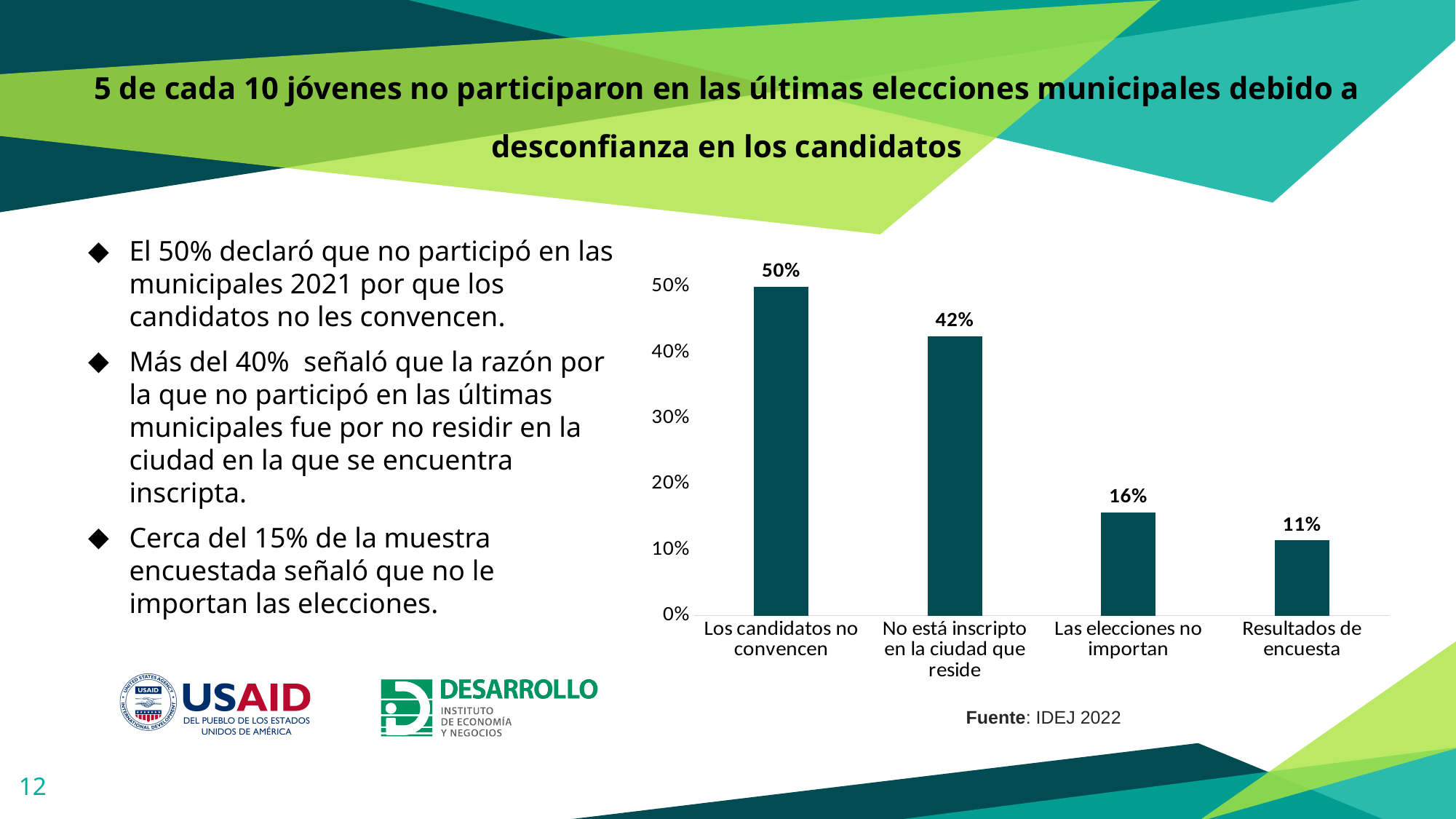
What is the difference between "Las elecciones no importan" and "Resultados de encuesta"? 5% What is the difference between "Los candidatos no convencen" and "No está inscripto en la ciudad que reside"? 8% What kind of chart is shown on the slide? Bar chart What is the value for "Resultados de encuesta"? 11% What is the value for "No está inscripto en la ciudad que reside"? 42% Do the values rise or fall from left to right along the x axis? Fall What is the value for "Las elecciones no importan"? 16% Which category has the lowest value? Resultados de encuesta Which is larger: "No está inscripto en la ciudad que reside" or "Las elecciones no importan"? No está inscripto en la ciudad que reside What is the value for "Los candidatos no convencen"? 50% How many categories are shown in the chart? 4 Which category has the highest value? Los candidatos no convencen